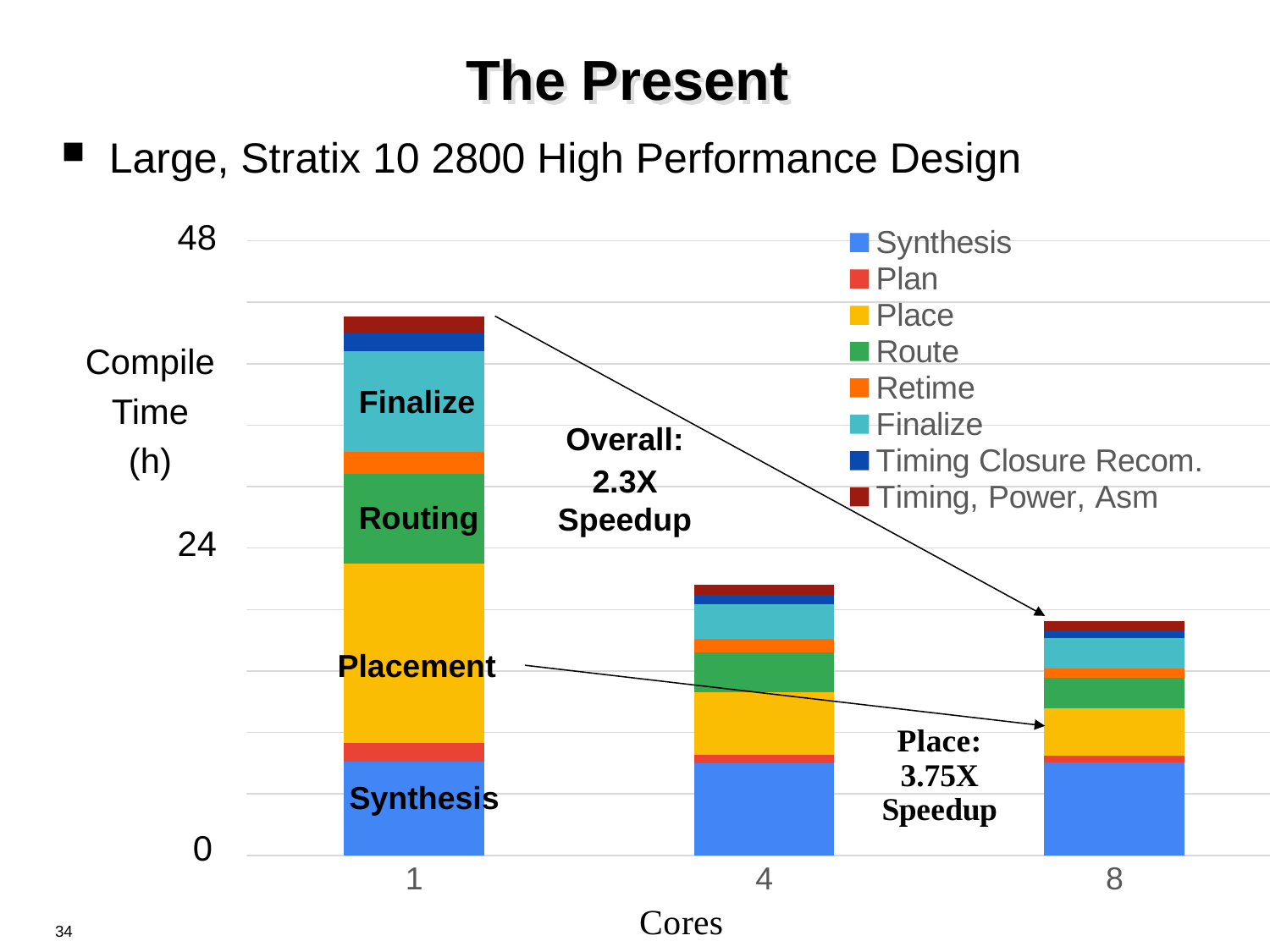
How many bars (core counts) are plotted on the chart? 3 Is the total compile time for 8 cores greater or less than 24? less Is the total compile time for 4 cores greater or less than 24? less Which core count has the lowest total compile time? 8 Which core count has the highest total compile time? 1 What overall speedup is annotated on the chart between 1 core and 8 cores? 2.3X What kind of chart is shown on the slide? stacked bar chart Which stage takes up the largest segment of the 1-core bar? Placement Is the total compile time for 1 core greater or less than 24? greater Which has the larger total compile time, 4 cores or 8 cores? 4 cores How many series does the legend list? 8 Does total compile time rise or fall as the number of cores increases? fall